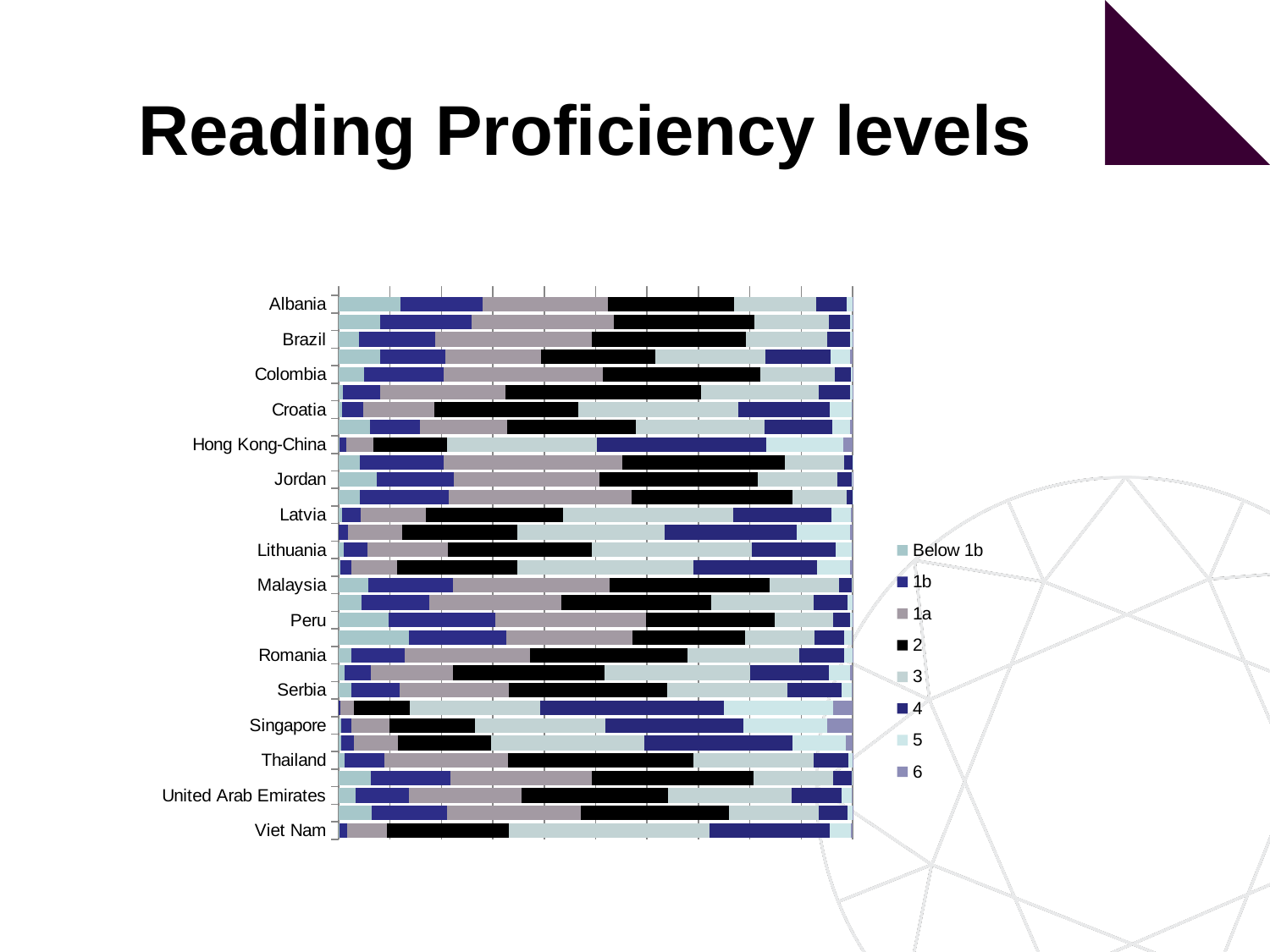
Which country has the larger '4' segment, Singapore or Peru? Singapore What is the title of the chart on the slide? Reading Proficiency levels Which series is listed first in the legend? Below 1b For Hong Kong-China, which segment is larger: the '1b' segment or the '4' segment? 4 For Viet Nam, which segment is larger: the '1b' segment or the '3' segment? 3 What kind of chart is shown on the slide? Stacked bar chart How many series does the legend list? 8